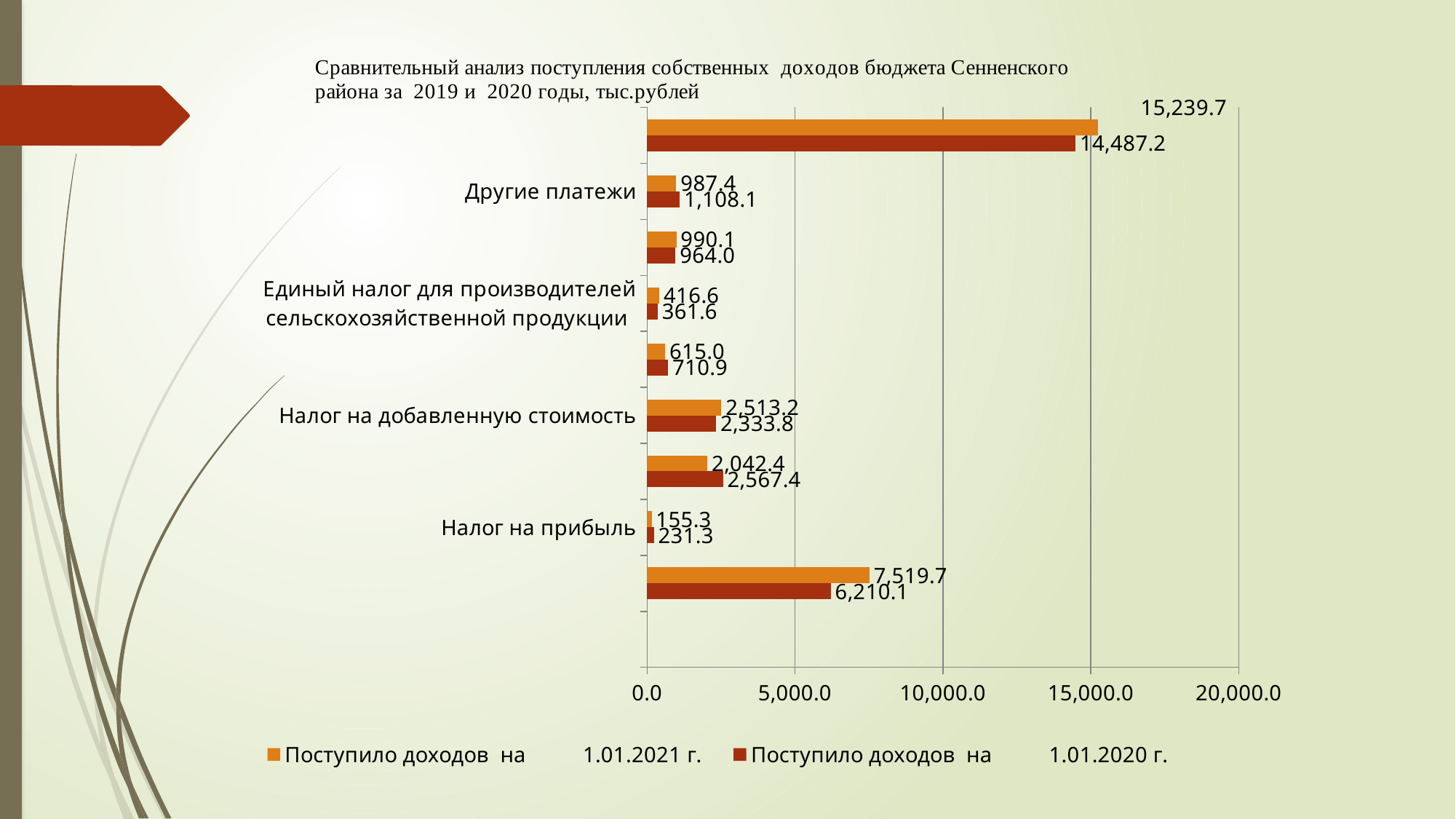
What is the value for Другие платежи in the series Поступило доходов на 1.01.2021 г.? 987.4 What is the largest value shown for the series Поступило доходов на 1.01.2021 г.? 15,239.7 For Налог на прибыль, which series has the larger value: Поступило доходов на 1.01.2021 г. or Поступило доходов на 1.01.2020 г.? Поступило доходов на 1.01.2020 г. How many category groups of bars are plotted in the chart? 9 What type of chart is shown on the slide? bar chart What is the value for Налог на добавленную стоимость in the series Поступило доходов на 1.01.2020 г.? 2,333.8 What is the value for Единый налог для производителей сельскохозяйственной продукции in the series Поступило доходов на 1.01.2020 г.? 361.6 What is the difference between the 1.01.2021 г. and 1.01.2020 г. values for Налог на добавленную стоимость? 179.4 What is the value for Налог на прибыль in the series Поступило доходов на 1.01.2021 г.? 155.3 How many series does the legend list? 2 Is the value for Налог на добавленную стоимость in the series Поступило доходов на 1.01.2021 г. greater or less than 5,000.0? less What is the difference between the 1.01.2020 г. and 1.01.2021 г. values for Другие платежи? 120.7